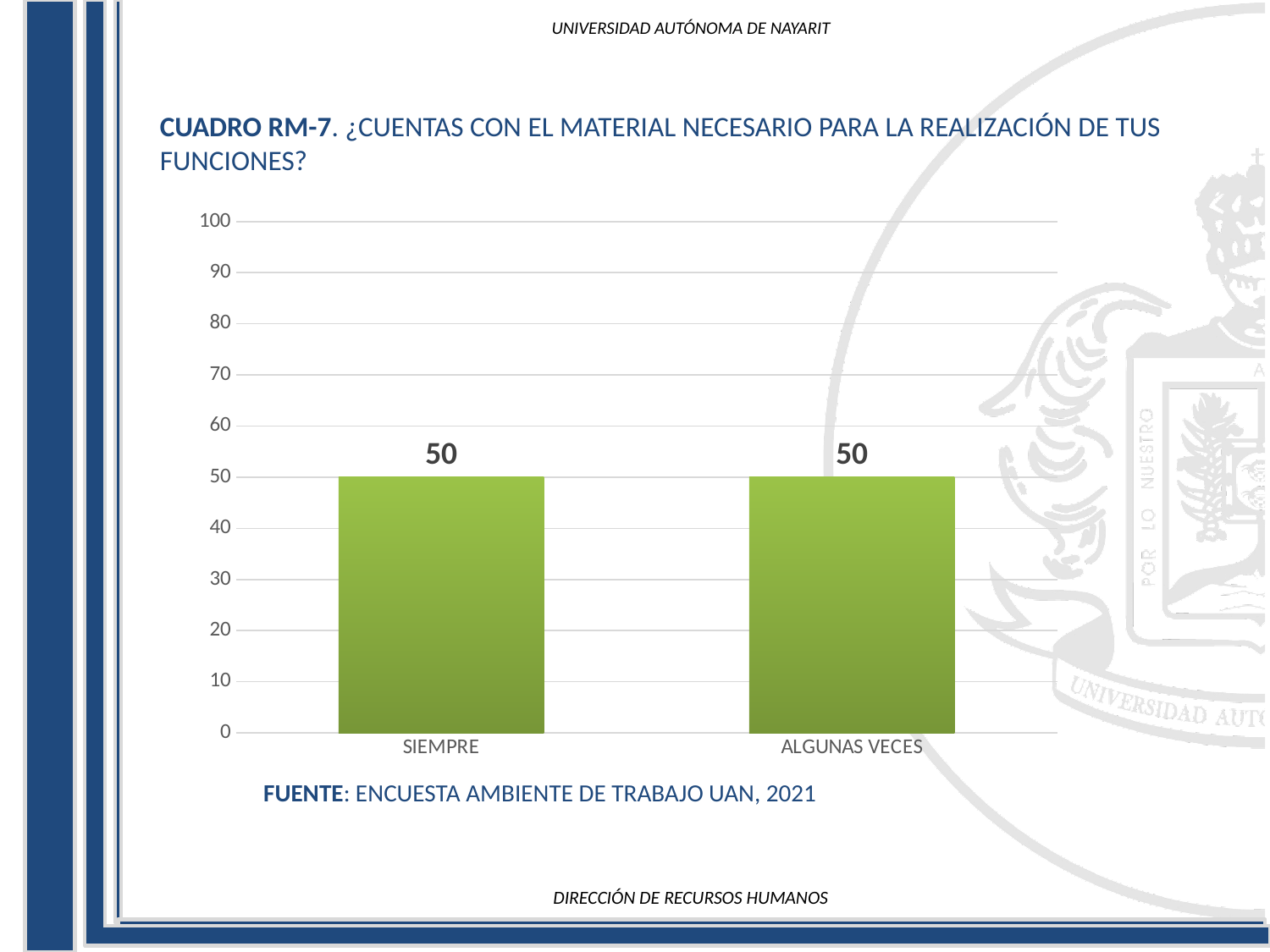
What is the value for ALGUNAS VECES? 50 What is the total of the values for SIEMPRE and ALGUNAS VECES? 100 Is the value for ALGUNAS VECES greater or less than 40? greater Is the value for SIEMPRE greater or less than 60? less How many categories are shown on the x axis? 2 What is the maximum value shown on the y axis? 100 What is the difference between the values for SIEMPRE and ALGUNAS VECES? 0 What is the value for SIEMPRE? 50 What kind of chart is shown on the slide? bar chart What source is cited below the chart? ENCUESTA AMBIENTE DE TRABAJO UAN, 2021